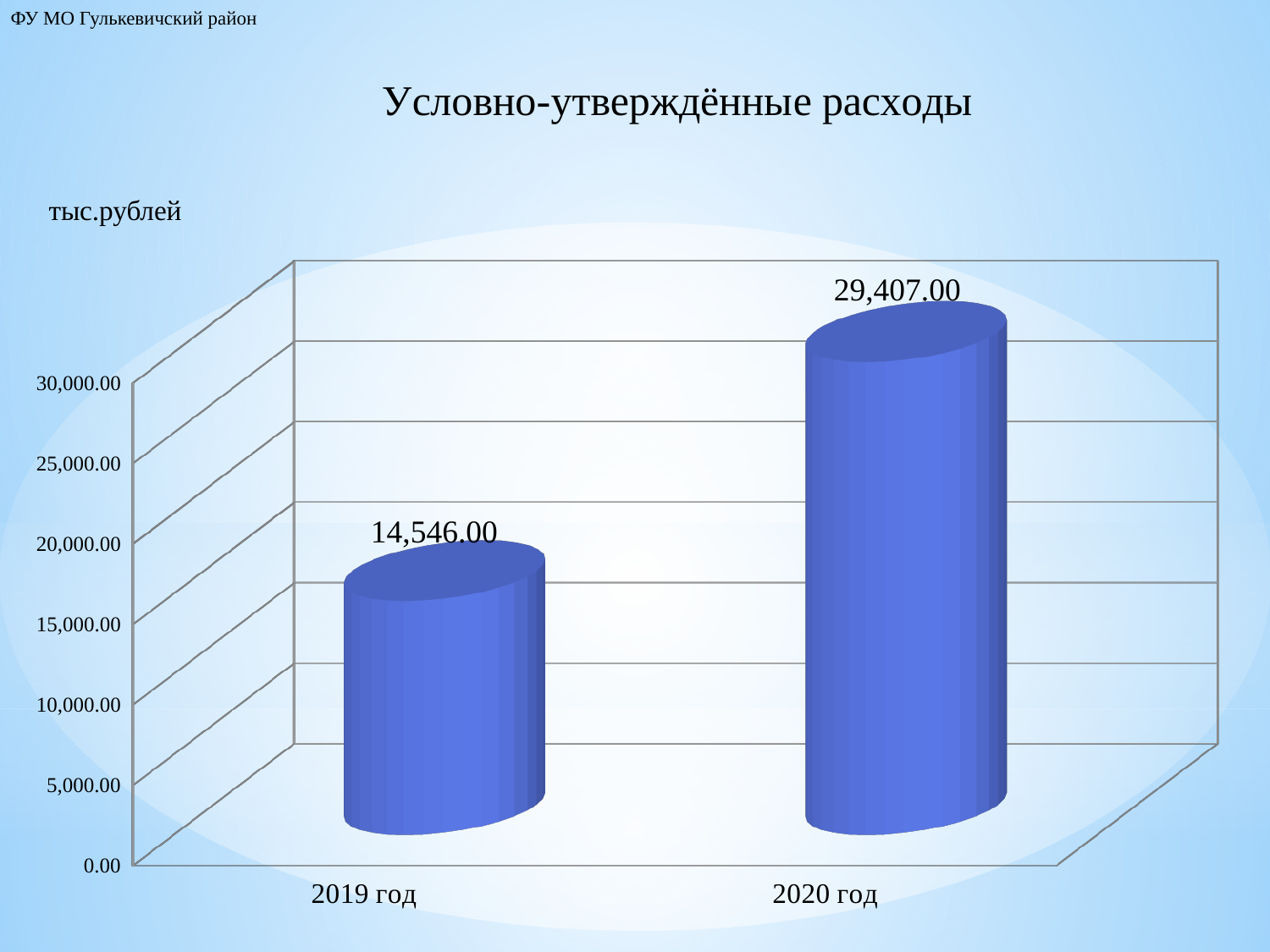
What kind of chart is shown on the slide? bar chart Is the value for 2019 год greater or less than 20,000.00? less What is the title of the chart? Условно-утверждённые расходы What is the value for 2020 год? 29,407.00 Which year has the highest value? 2020 год Is the value for 2020 год greater or less than 25,000.00? greater Do the values rise or fall from 2019 год to 2020 год? rise What is the difference between the values for 2020 год and 2019 год? 14,861.00 How many categories are shown on the x axis? 2 Which year has the lowest value? 2019 год Which is larger, the value for 2019 год or the value for 2020 год? 2020 год What is the value for 2019 год? 14,546.00